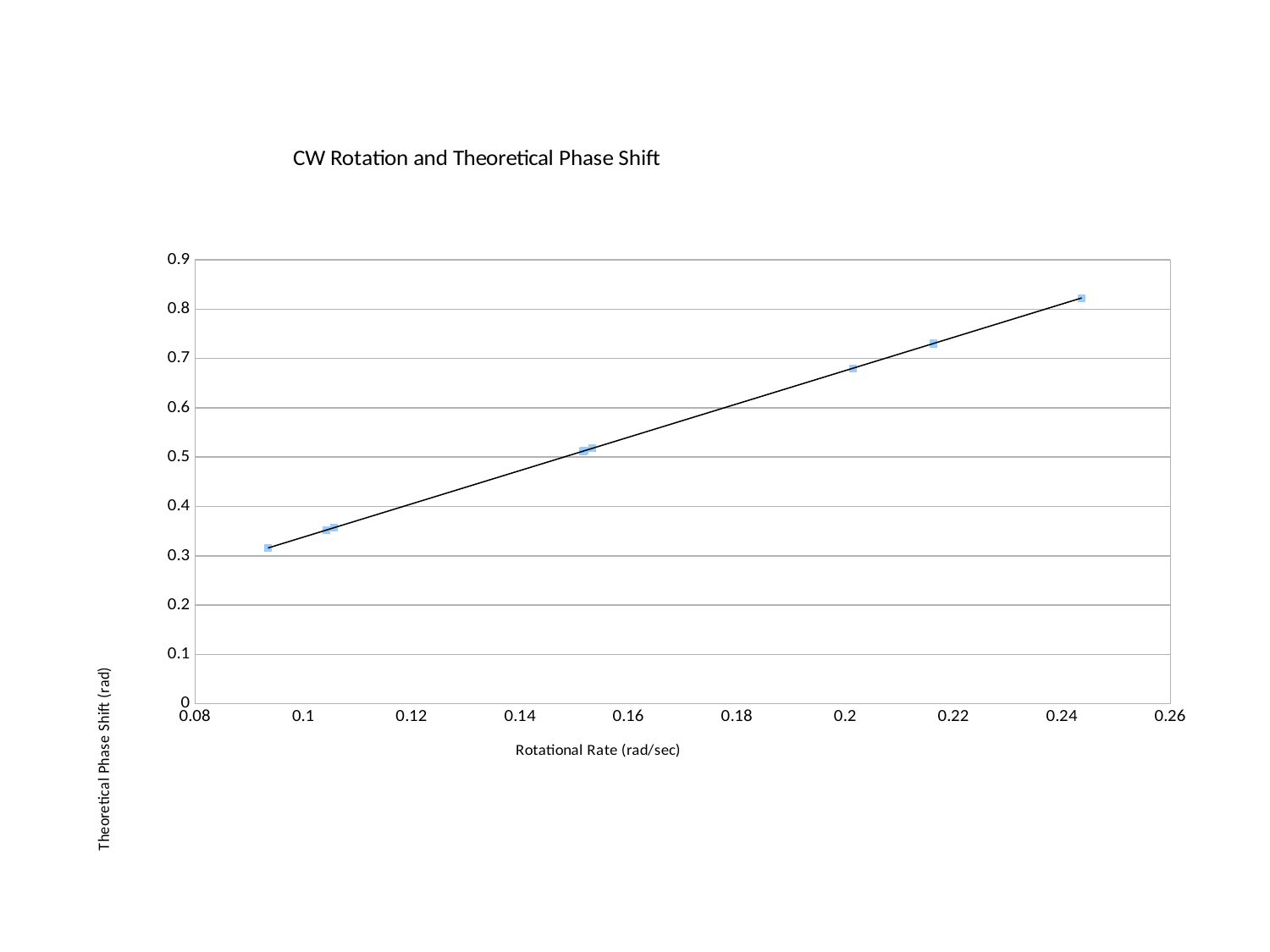
What kind of chart is shown on the slide? scatter chart Is the theoretical phase shift at the lowest rotational rate (near 0.09 rad/sec) greater or less than 0.4? less What is the label of the x axis? Rotational Rate (rad/sec) Is the theoretical phase shift for the point near 0.2 rad/sec greater or less than 0.6? greater Does the theoretical phase shift rise or fall as the rotational rate increases? rise Is the theoretical phase shift at the highest rotational rate (near 0.24 rad/sec) greater or less than 0.8? greater What is the title of the chart? CW Rotation and Theoretical Phase Shift Which has the smaller theoretical phase shift: the point near 0.09 rad/sec or the points near 0.15 rad/sec? the point near 0.09 rad/sec Which has the larger theoretical phase shift: the point near 0.2 rad/sec or the point near 0.24 rad/sec? the point near 0.24 rad/sec